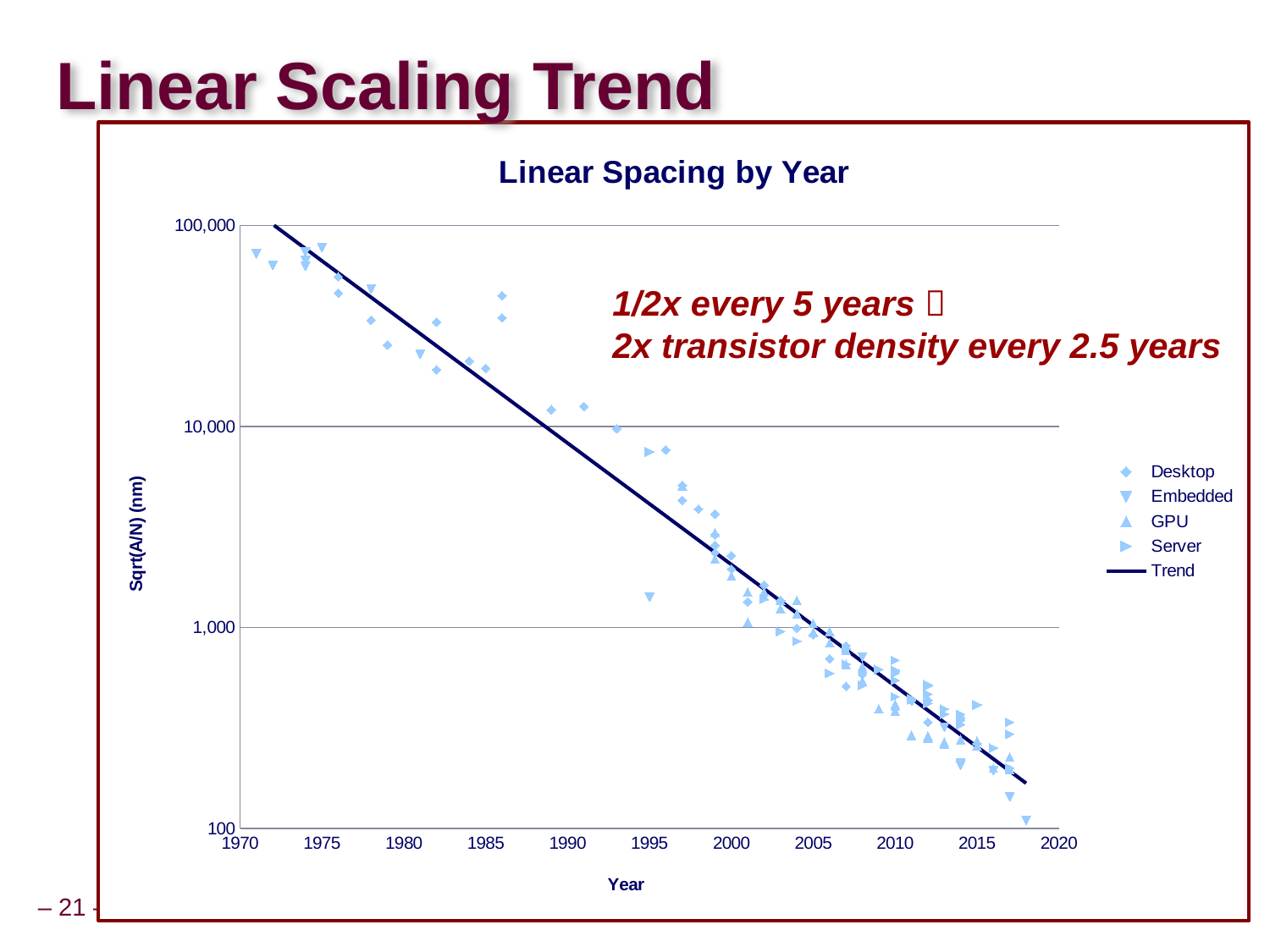
Which is larger: the Desktop value plotted around 1975 or the Desktop value plotted around 2005? the Desktop value around 1975 What kind of chart is shown on the slide? scatter chart Are the Desktop values plotted around 2015 greater or less than 1,000? less Are the Desktop values plotted around 1980 greater or less than 10,000? greater Do the plotted values rise or fall as the year increases along the x axis? fall Is the Trend line value at 2018 greater or less than 1,000? less What is the label on the y axis of the chart? Sqrt(A/N) (nm) Which legend entry is drawn as a line rather than markers? Trend How many entries does the chart legend list? 5 What is the title of the chart? Linear Spacing by Year